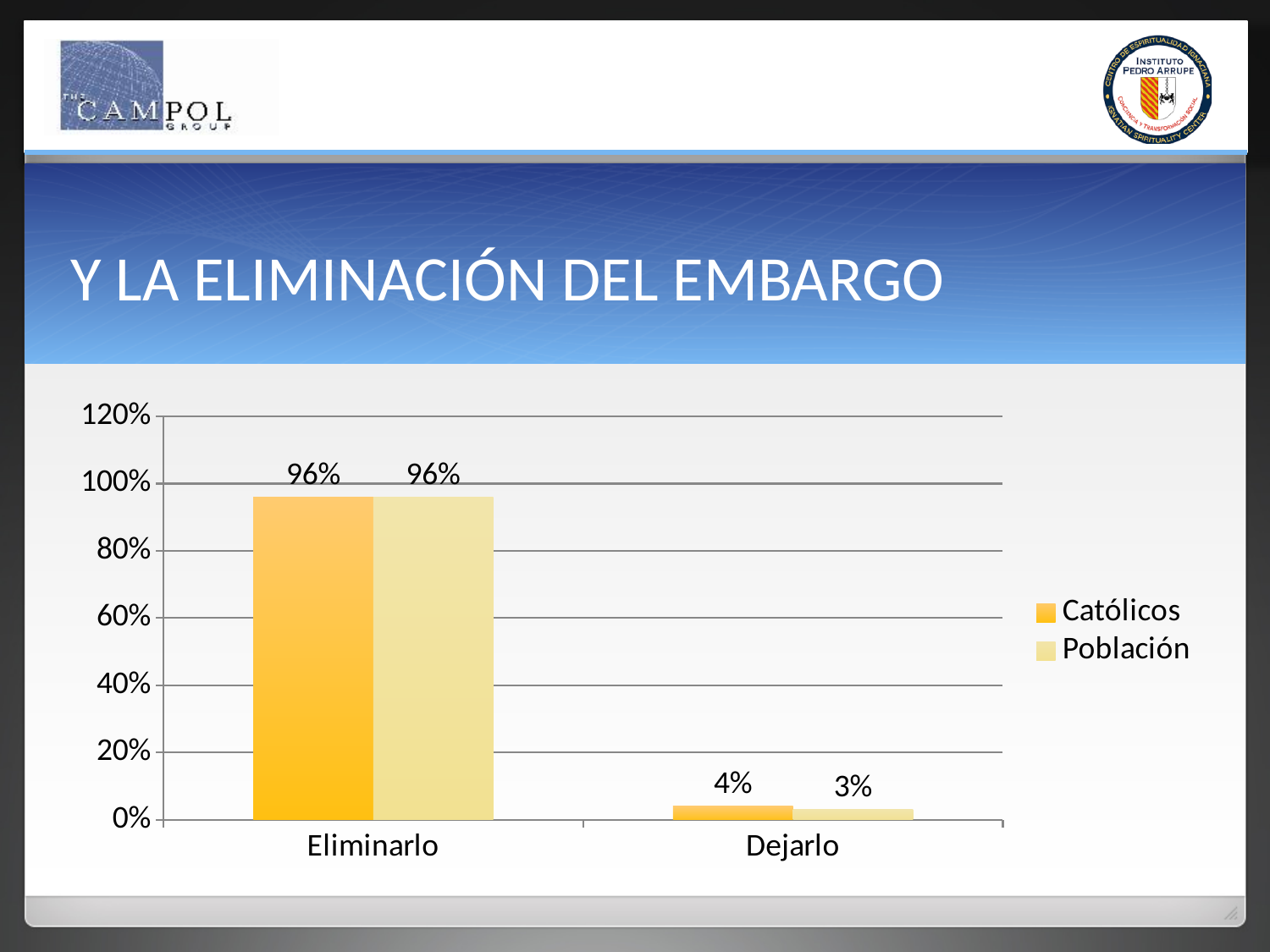
What is the value for Población in the Dejarlo category? 3% Which category has the highest value for Católicos? Eliminarlo How many categories are shown on the x axis? 2 What is the difference between the Católicos values for Eliminarlo and Dejarlo? 92% Which category has the lowest value for Población? Dejarlo What is the value for Católicos in the Eliminarlo category? 96% How many series does the legend list? 2 What is the difference between the Católicos and Población values for Dejarlo? 1% What is the value for Católicos in the Dejarlo category? 4% What is the value for Población in the Eliminarlo category? 96% What kind of chart is shown on the slide? Bar chart Which is larger: the Católicos value for Eliminarlo or the Católicos value for Dejarlo? Eliminarlo